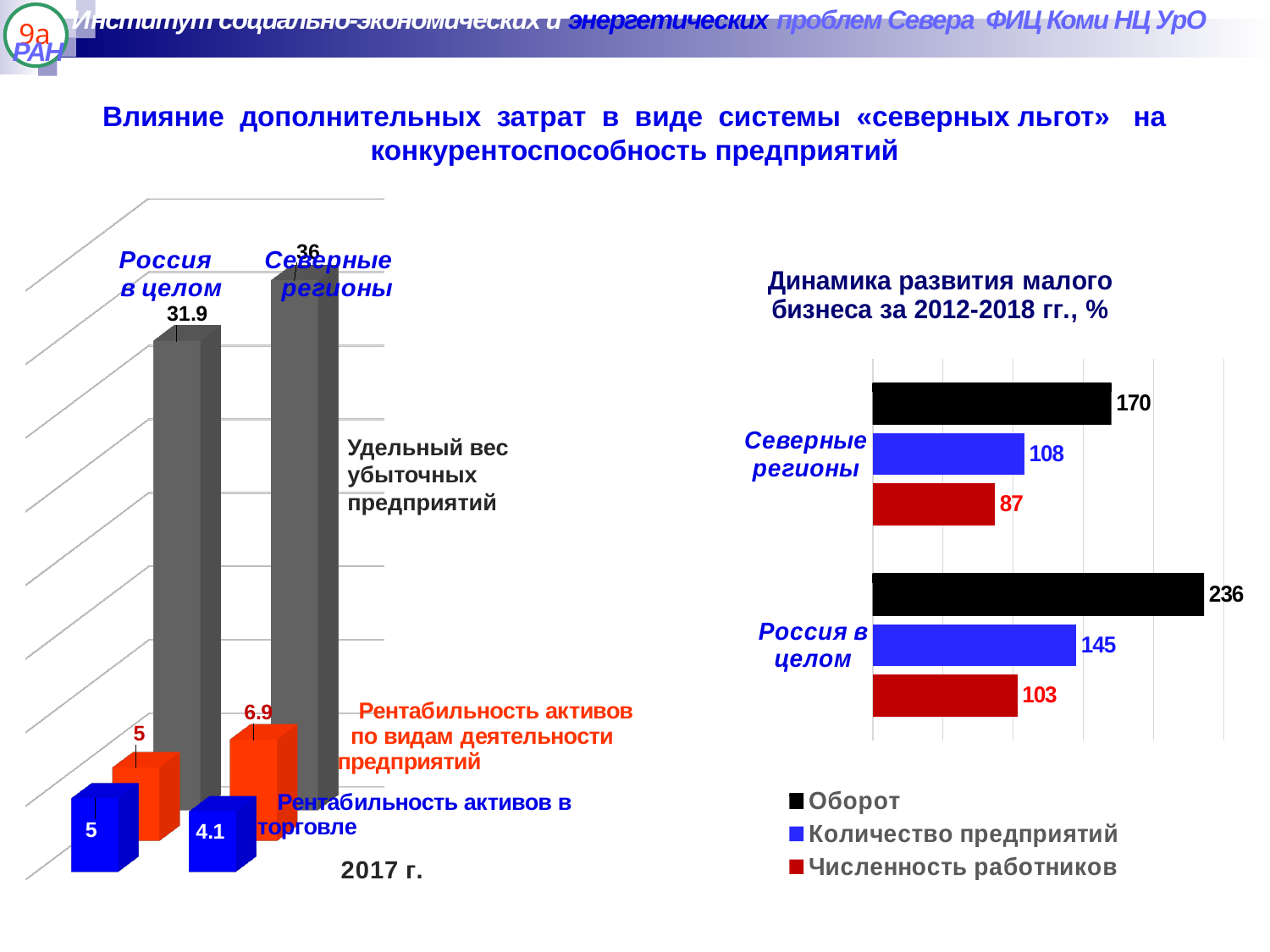
In the chart on the left of the slide, what is the value of 'Удельный вес убыточных предприятий' for 'Северные регионы'? 36 In the chart on the left of the slide, what is the difference between 'Удельный вес убыточных предприятий' for 'Северные регионы' and for 'Россия в целом'? 4.1 In the chart on the left of the slide, what is the value of 'Рентабельность активов в торговле' for 'Северные регионы'? 4.1 In the chart titled 'Динамика развития малого бизнеса за 2012-2018 гг., %', what is the value of 'Количество предприятий' for 'Россия в целом'? 145 In the chart titled 'Динамика развития малого бизнеса за 2012-2018 гг., %', what kind of chart is it? Bar chart In the chart titled 'Динамика развития малого бизнеса за 2012-2018 гг., %', which colour represents 'Количество предприятий'? Blue In the chart on the left of the slide, which is larger: 'Рентабельность активов по видам деятельности предприятий' for 'Россия в целом' or for 'Северные регионы'? Северные регионы In the chart titled 'Динамика развития малого бизнеса за 2012-2018 гг., %', what is the difference between 'Оборот' for 'Россия в целом' and 'Оборот' for 'Северные регионы'? 66 In the chart titled 'Динамика развития малого бизнеса за 2012-2018 гг., %', what is the value of 'Оборот' for 'Россия в целом'? 236 In the chart titled 'Динамика развития малого бизнеса за 2012-2018 гг., %', which series has the highest value for 'Северные регионы'? Оборот In the chart titled 'Динамика развития малого бизнеса за 2012-2018 гг., %', how many series does the legend list? 3 In the chart titled 'Динамика развития малого бизнеса за 2012-2018 гг., %', what is the value of 'Численность работников' for 'Северные регионы'? 87